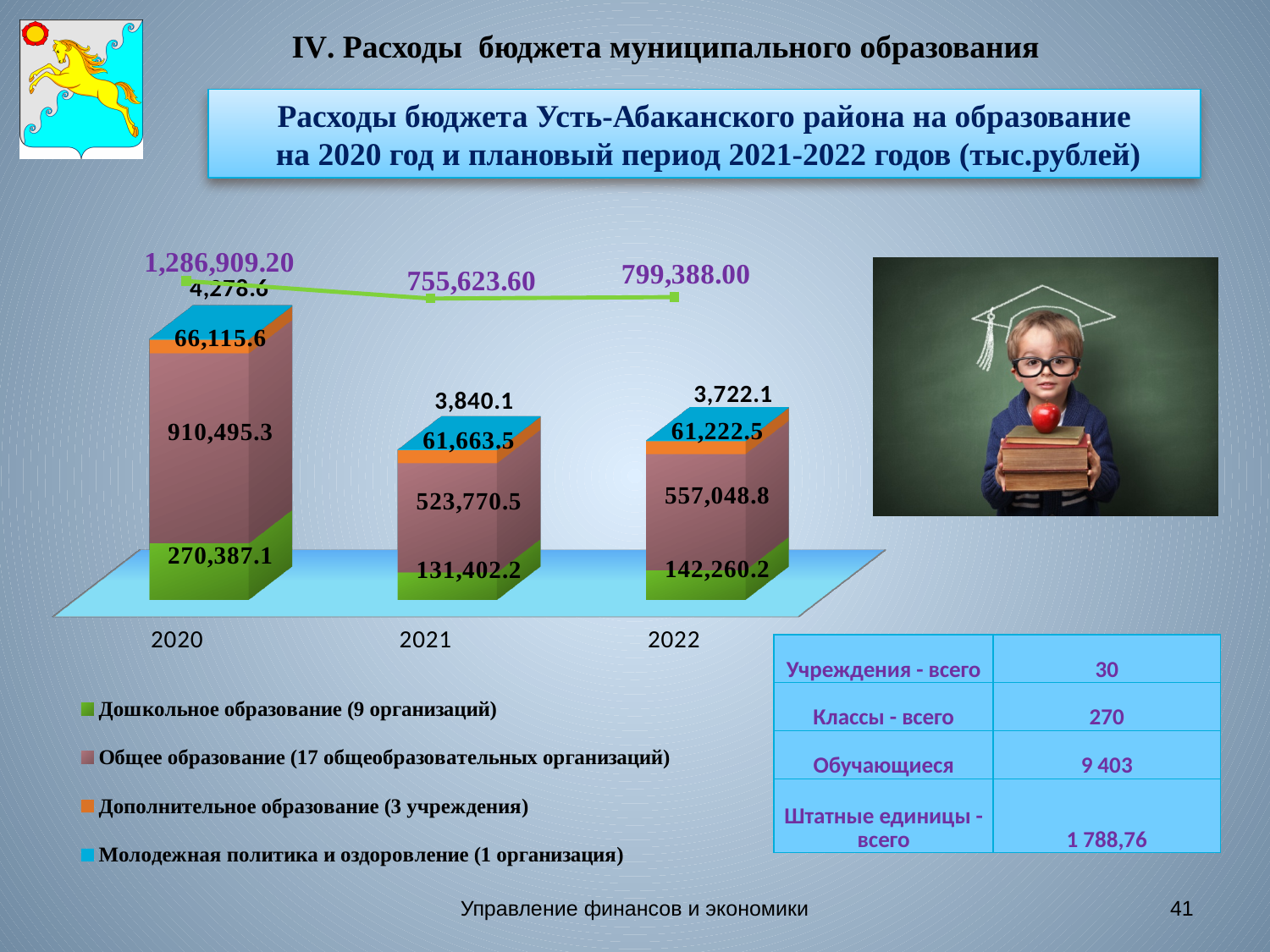
Which year has the lowest value for Дошкольное образование? 2021 What is the value for Дошкольное образование in 2021? 131,402.2 What is the value for Молодежная политика и оздоровление in 2021? 3,840.1 Which year has the highest value for Общее образование? 2020 How many years are shown on the x axis of the chart? 3 Which is larger: Дополнительное образование in 2021 or in 2022? 2021 What is the difference between the Общее образование values for 2022 and 2021? 33,278.3 What is the value for Общее образование in 2020? 910,495.3 What total is shown by the line for 2020? 1,286,909.20 How many series does the chart legend list? 4 What is the value for Дополнительное образование in 2022? 61,222.5 What total is shown by the line for 2022? 799,388.00